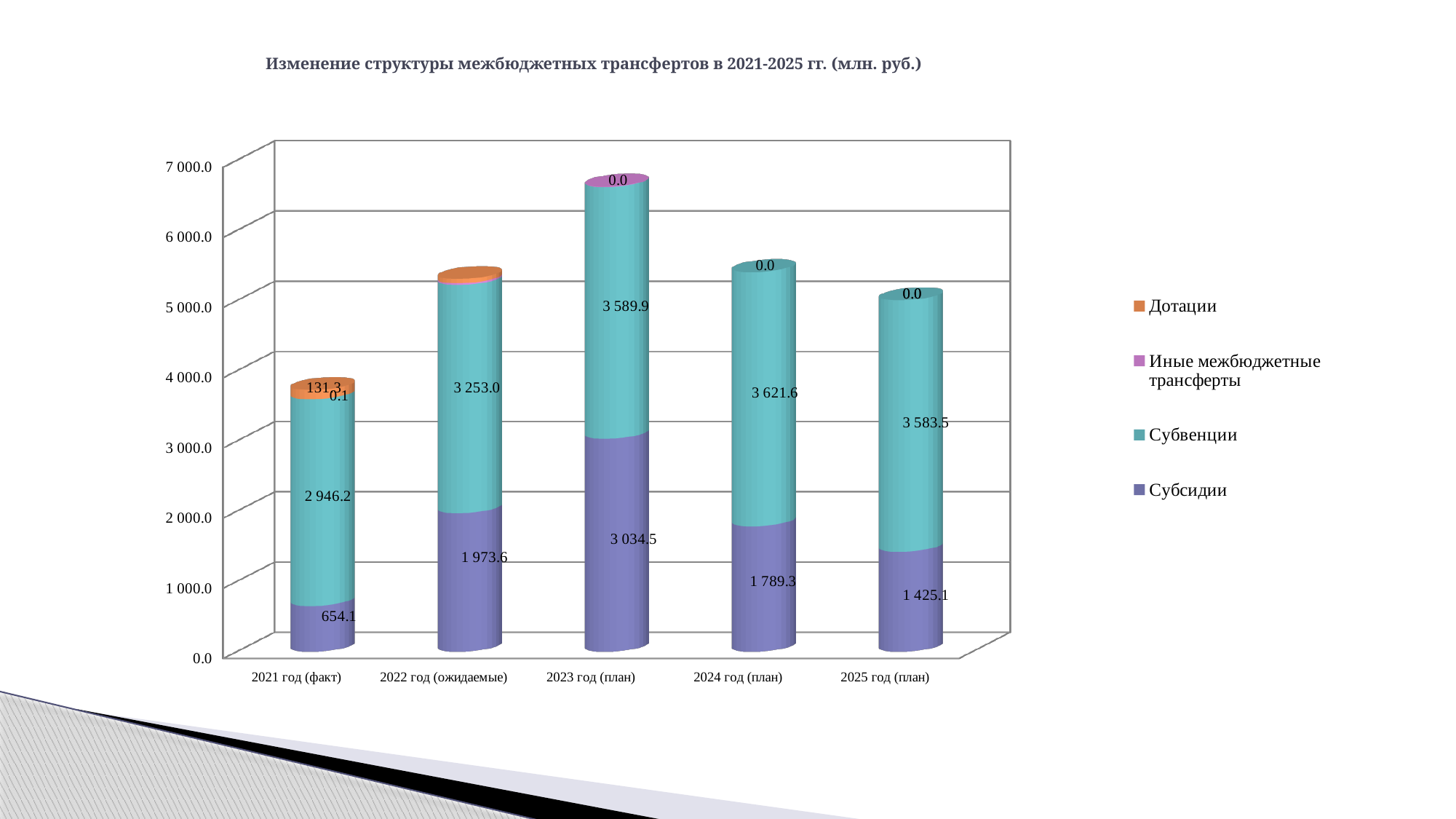
How many series does the legend list? 4 What is the value of Дотации for 2021 год (факт)? 131.3 What is the total of the stacked bar for 2021 год (факт)? 3 731.7 In which year is the Субсидии value the lowest? 2021 год (факт) How many year categories are shown on the x axis? 5 What is the value of Субсидии for 2021 год (факт)? 654.1 What kind of chart is shown on the slide? stacked bar chart What is the difference between the Субсидии values for 2023 год (план) and 2021 год (факт)? 2 380.4 In which year is the Субсидии value the highest? 2023 год (план) Which is larger: Субвенции for 2022 год (ожидаемые) or Субвенции for 2025 год (план)? 2025 год (план) What is the value of Субвенции for 2024 год (план)? 3 621.6 Is the total stacked value for 2023 год (план) greater or less than 6 000.0? greater